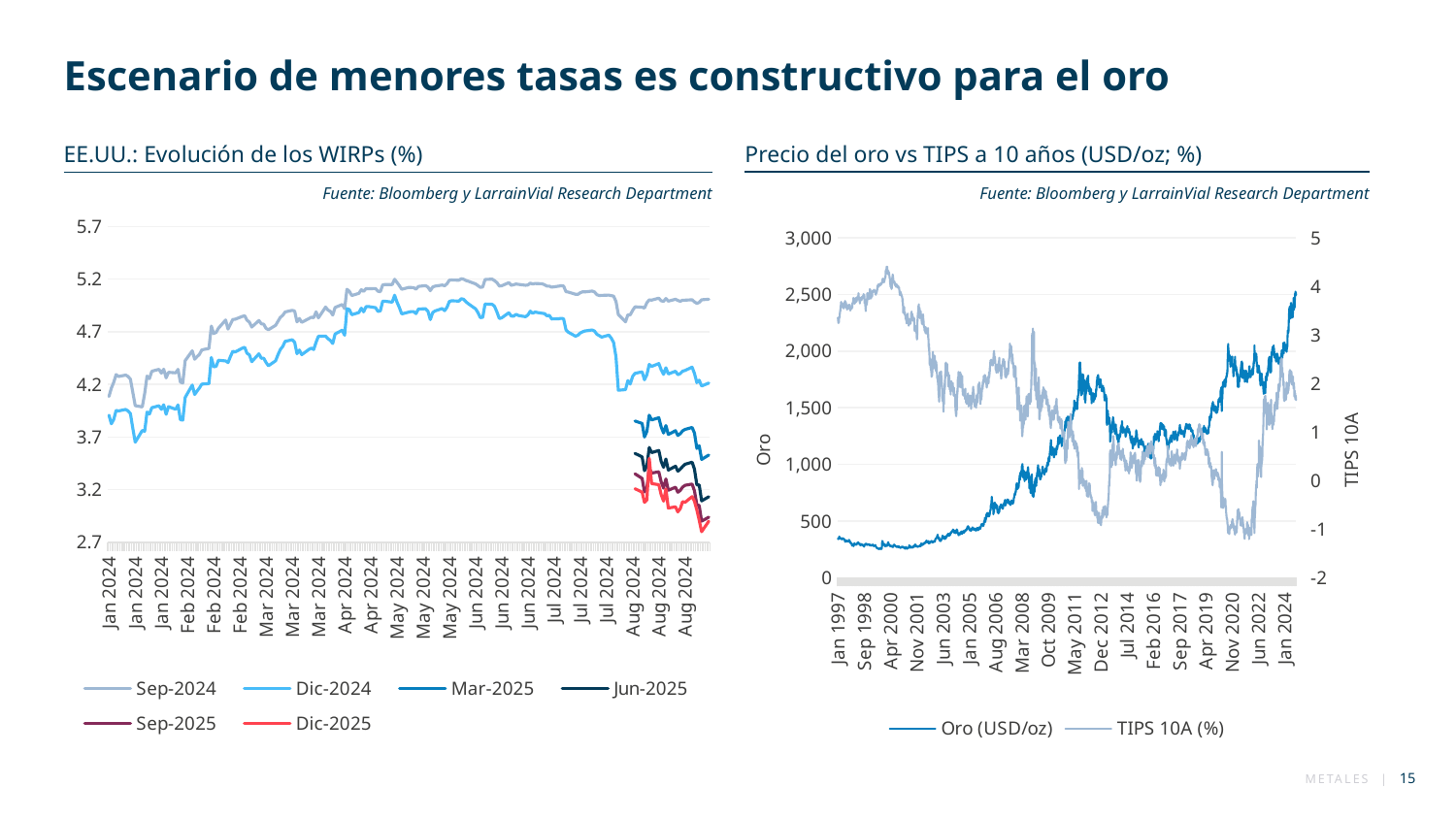
In the 'Precio del oro vs TIPS a 10 años' chart, is the gold price (Oro) at the end of the series in 2024 greater or less than 2,000 USD/oz? greater In the 'EE.UU.: Evolución de los WIRPs (%)' chart, which series has the lowest values at the end of the period (Aug 2024)? Dic-2025 What kind of chart is the 'EE.UU.: Evolución de los WIRPs (%)' chart on the left? line chart In the 'EE.UU.: Evolución de los WIRPs (%)' chart, which series has the highest values across the period shown? Sep-2024 In the 'EE.UU.: Evolución de los WIRPs (%)' chart, which series is higher in Aug 2024, Mar-2025 or Jun-2025? Mar-2025 What is the source cited under the 'Precio del oro vs TIPS a 10 años' chart? Bloomberg y LarrainVial Research Department In the 'Precio del oro vs TIPS a 10 años' chart, is the gold price (Oro) in Jan 1997 greater or less than 500 USD/oz? less In the 'EE.UU.: Evolución de los WIRPs (%)' chart, is the value of the Dic-2025 series at the end of Aug 2024 greater or less than 3.2? less How many series does the legend of the 'Precio del oro vs TIPS a 10 años' chart list? 2 In the 'Precio del oro vs TIPS a 10 años' chart, does the TIPS 10A (%) series overall rise or fall from Jan 1997 to Jan 2024? fall How many series does the legend of the 'EE.UU.: Evolución de los WIRPs (%)' chart list? 6